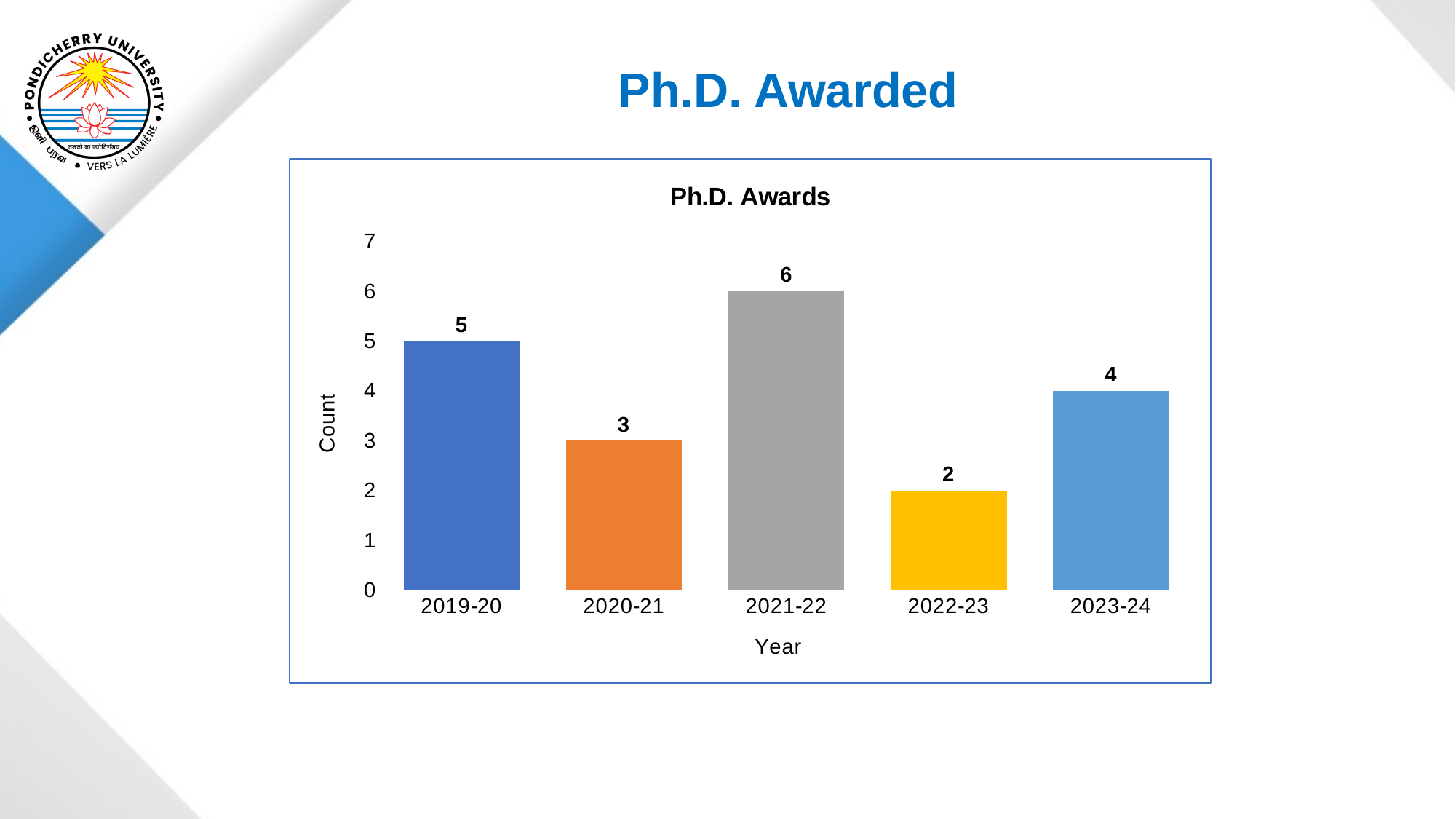
What is the value shown for 2022-23? 2 How many years are shown on the x axis of the chart? 5 Which year has the highest number of Ph.D. awards? 2021-22 Which year had more Ph.D. awards, 2020-21 or 2023-24? 2023-24 What kind of chart is shown on the slide? Bar chart Is the value for 2023-24 greater or less than 3? greater How many Ph.D. awards were there in 2019-20? 5 What is the label of the vertical axis? Count Which year has the lowest number of Ph.D. awards? 2022-23 What is the count of Ph.D. awards for 2021-22? 6 What is the difference between the Ph.D. awards in 2021-22 and 2022-23? 4 What is the title of the chart? Ph.D. Awards